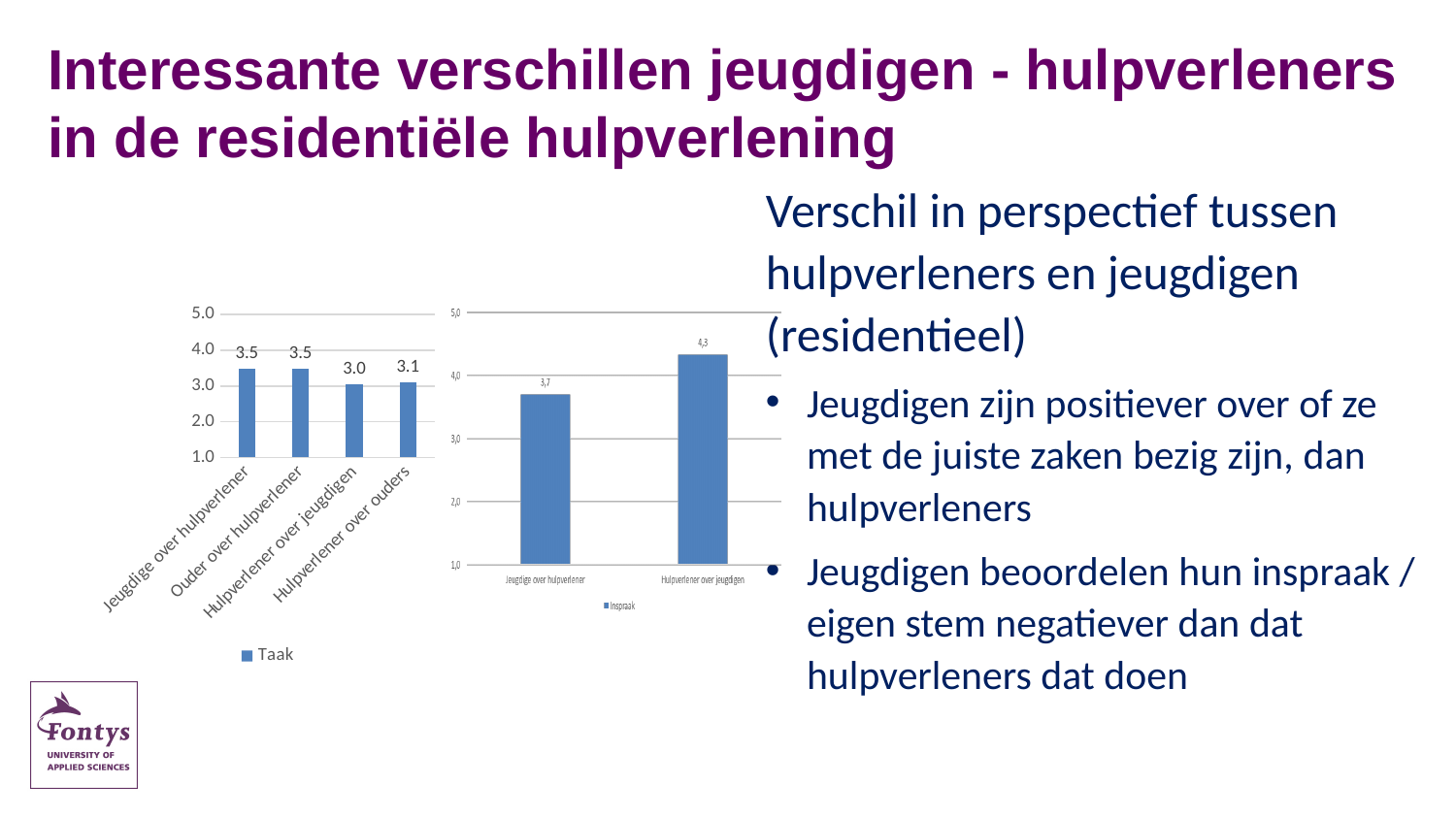
In the left chart (legend 'Taak'), what is the difference between Jeugdige over hulpverlener and Hulpverlener over jeugdigen? 0.5 In the left chart (legend 'Taak'), which category has the lowest value? Hulpverlener over jeugdigen In the right chart (legend 'Inspraak'), what is the value for Jeugdige over hulpverlener? 3,7 In the right chart (legend 'Inspraak'), what is the value for Hulpverlener over jeugdigen? 4,3 In the left chart (legend 'Taak'), how many categories are shown? 4 In the right chart (legend 'Inspraak'), which category has the higher value? Hulpverlener over jeugdigen In the left chart (legend 'Taak'), what is the value for Hulpverlener over ouders? 3.1 What kind of chart is the right chart (legend 'Inspraak')? bar chart In the left chart, what series name does the legend show? Taak In the left chart (legend 'Taak'), what is the value for Hulpverlener over jeugdigen? 3.0 In the left chart (legend 'Taak'), what is the value for Ouder over hulpverlener? 3.5 In the right chart (legend 'Inspraak'), is the value for Hulpverlener over jeugdigen greater or less than 4,0? greater